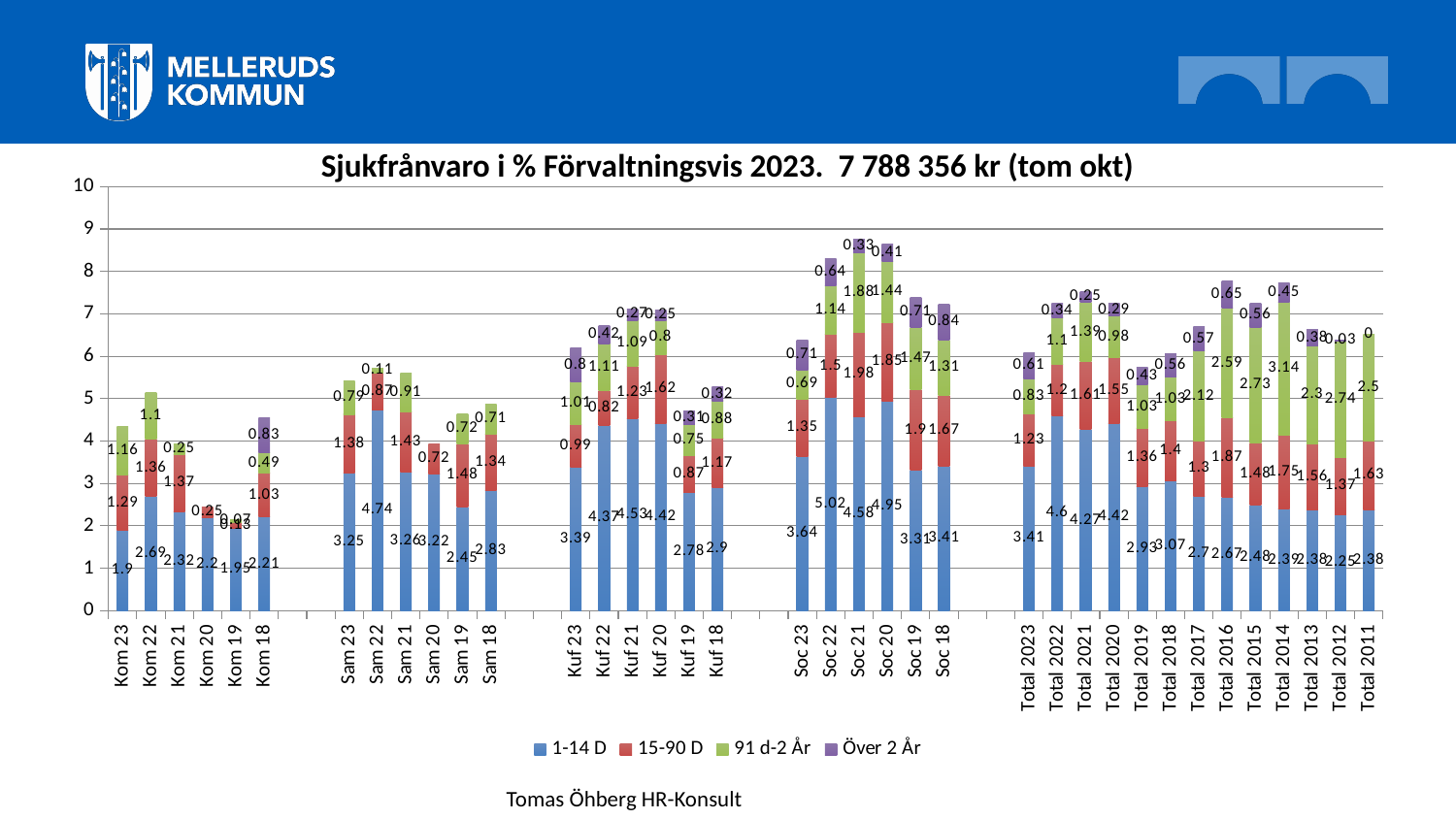
What is the Över 2 År value for Total 2016? 0.65 What is the 1-14 D value for Sam 22? 4.74 Which has the larger 1-14 D value, Kuf 22 or Kom 22? Kuf 22 What is the difference between the 1-14 D values for Sam 22 and Sam 23? 1.49 How many series does the legend list? 4 What is the 15-90 D value for Soc 21? 1.98 What kind of chart is shown on the slide? Stacked bar chart What is the 1-14 D value for Soc 22? 5.02 Among the Kom categories, which has the tallest stacked bar? Kom 22 What is the title of the chart? Sjukfrånvaro i % Förvaltningsvis 2023. 7 788 356 kr (tom okt) Among the Total categories, which has the highest 91 d-2 År value? Total 2014 Is the total stacked bar for Soc 22 greater or less than 8? greater